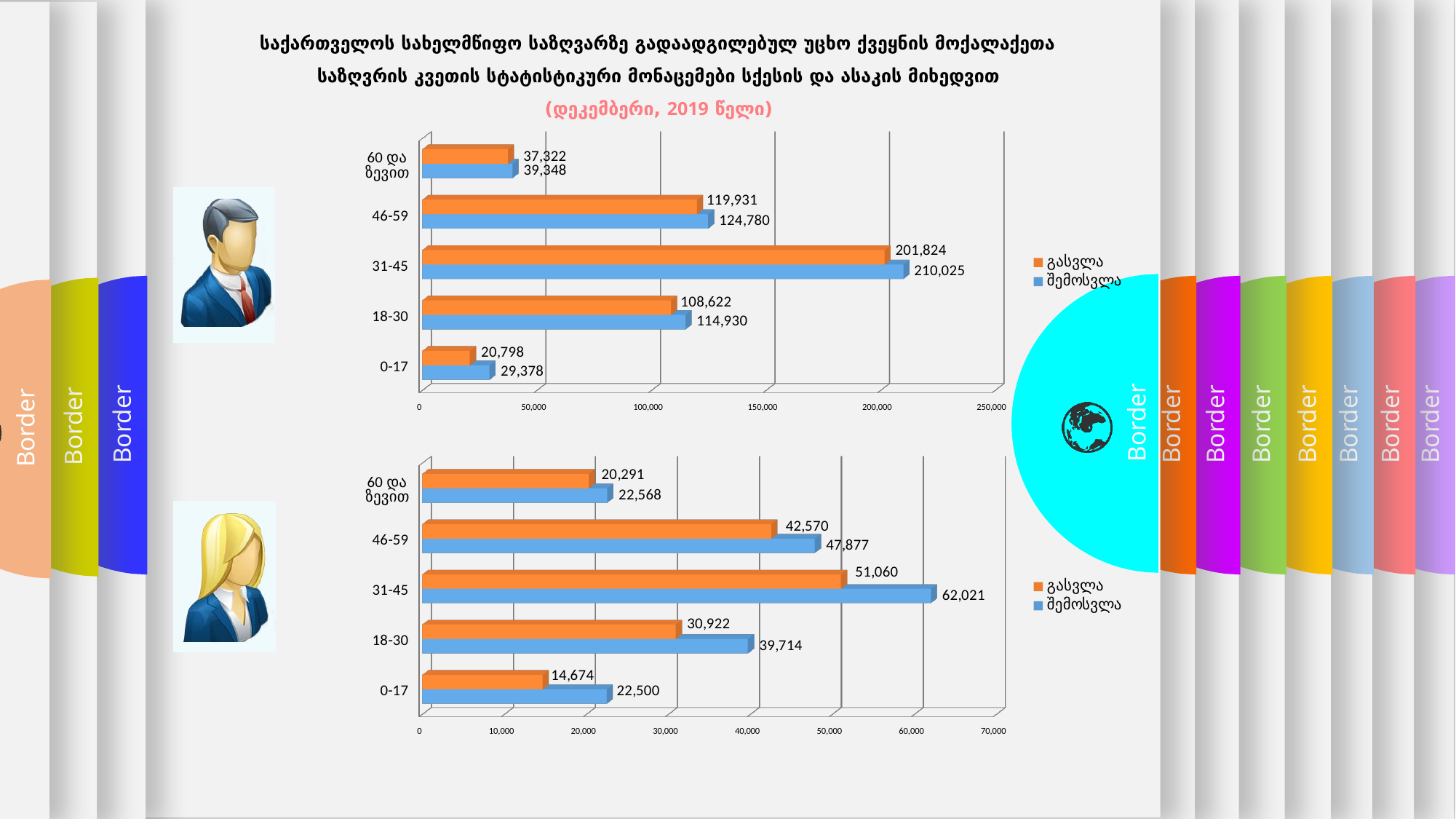
In the bottom chart, what is the difference between შემოსვლა and გასვლა for the 31-45 age group? 10,961 In the top chart, what is the value of შემოსვლა for the 31-45 age group? 210,025 In the top chart, what is the value of გასვლა for the 0-17 age group? 20,798 In the bottom chart, which is larger for the 0-17 age group: გასვლა or შემოსვლა? შემოსვლა In the top chart, what is the difference between შემოსვლა and გასვლა for the 46-59 age group? 4,849 In the bottom chart, what is the value of გასვლა for the 46-59 age group? 42,570 How many age groups are shown in the top chart? 5 In the bottom chart, what is the value of შემოსვლა for the 18-30 age group? 39,714 In the bottom chart, which age group has the lowest შემოსვლა value? 0-17 How many series does the legend of the bottom chart list? 2 What type of chart is the top chart? Bar chart In the top chart, which age group has the highest გასვლა value? 31-45